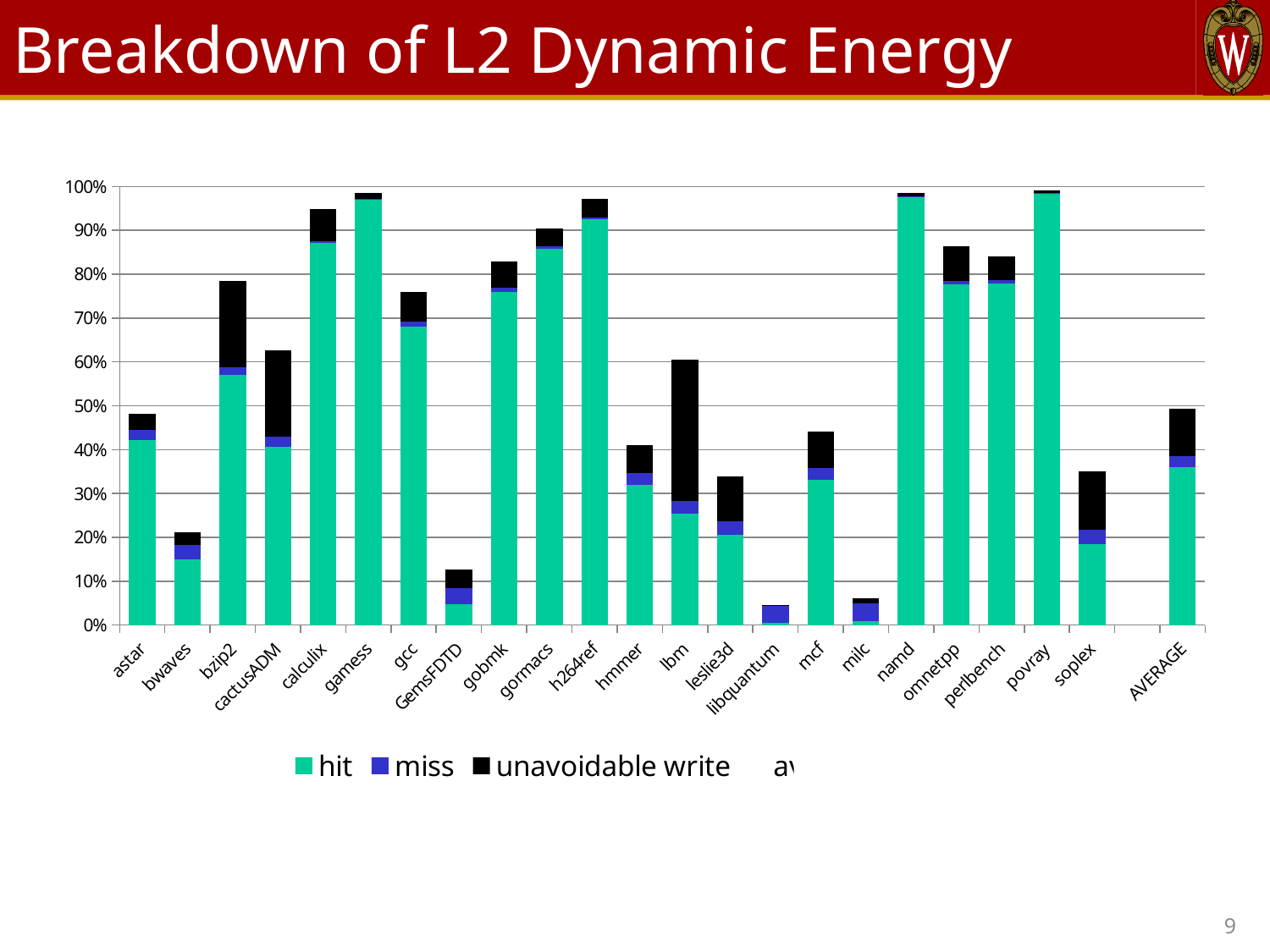
Which has the larger 'hit' value, gamess or gcc? gamess Is the total value for soplex greater or less than 30%? greater Which colour represents the 'hit' series in the legend? Green Is the total value for AVERAGE greater or less than 40%? greater Is the total value for gamess greater or less than 90%? greater How many categories are plotted along the x axis? 23 Which has the larger total value, bzip2 or cactusADM? bzip2 What is the title of the chart? Breakdown of L2 Dynamic Energy What kind of chart is shown on the slide? Stacked bar chart